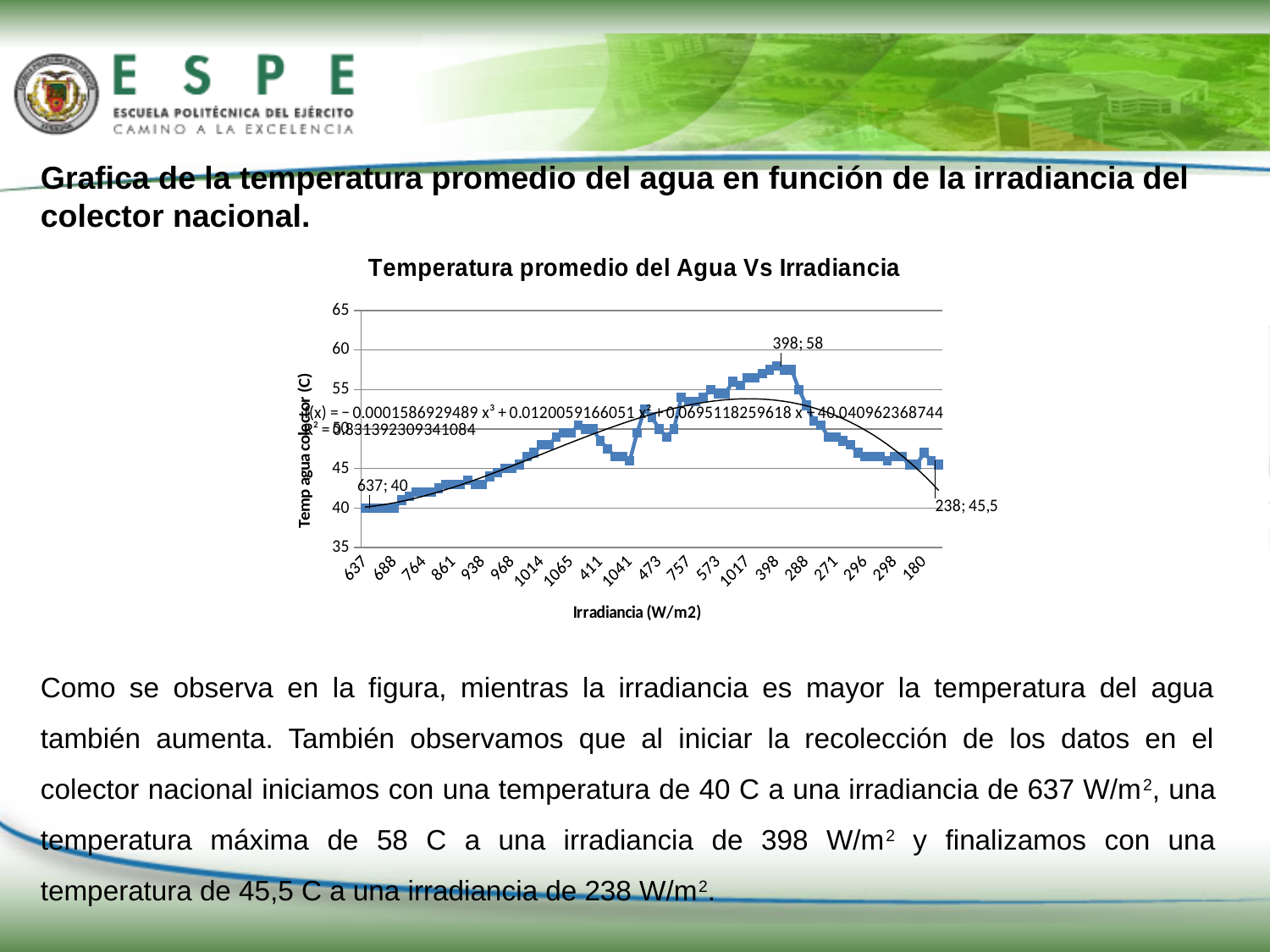
Is the water temperature at the x-axis label 1041 greater or less than 50? less What is the water temperature at an irradiance of 637 W/m2? 40 What is the label of the vertical axis? Temp agua colector (C) What is the water temperature at an irradiance of 398 W/m2? 58 Does the water temperature rise or fall along the x axis from 637 to 398? rise What is the difference between the temperature at 398 W/m2 and the temperature at 238 W/m2? 12,5 At which irradiance value does the water temperature reach its labelled maximum? 398 Which has the higher water temperature, the point at 637 W/m2 or the point at 238 W/m2? 238 W/m2 What is the water temperature at an irradiance of 238 W/m2? 45,5 What is the title of the chart? Temperatura promedio del Agua Vs Irradiancia What kind of chart is shown on the slide? line chart What is the difference between the temperature at 398 W/m2 and the temperature at 637 W/m2? 18